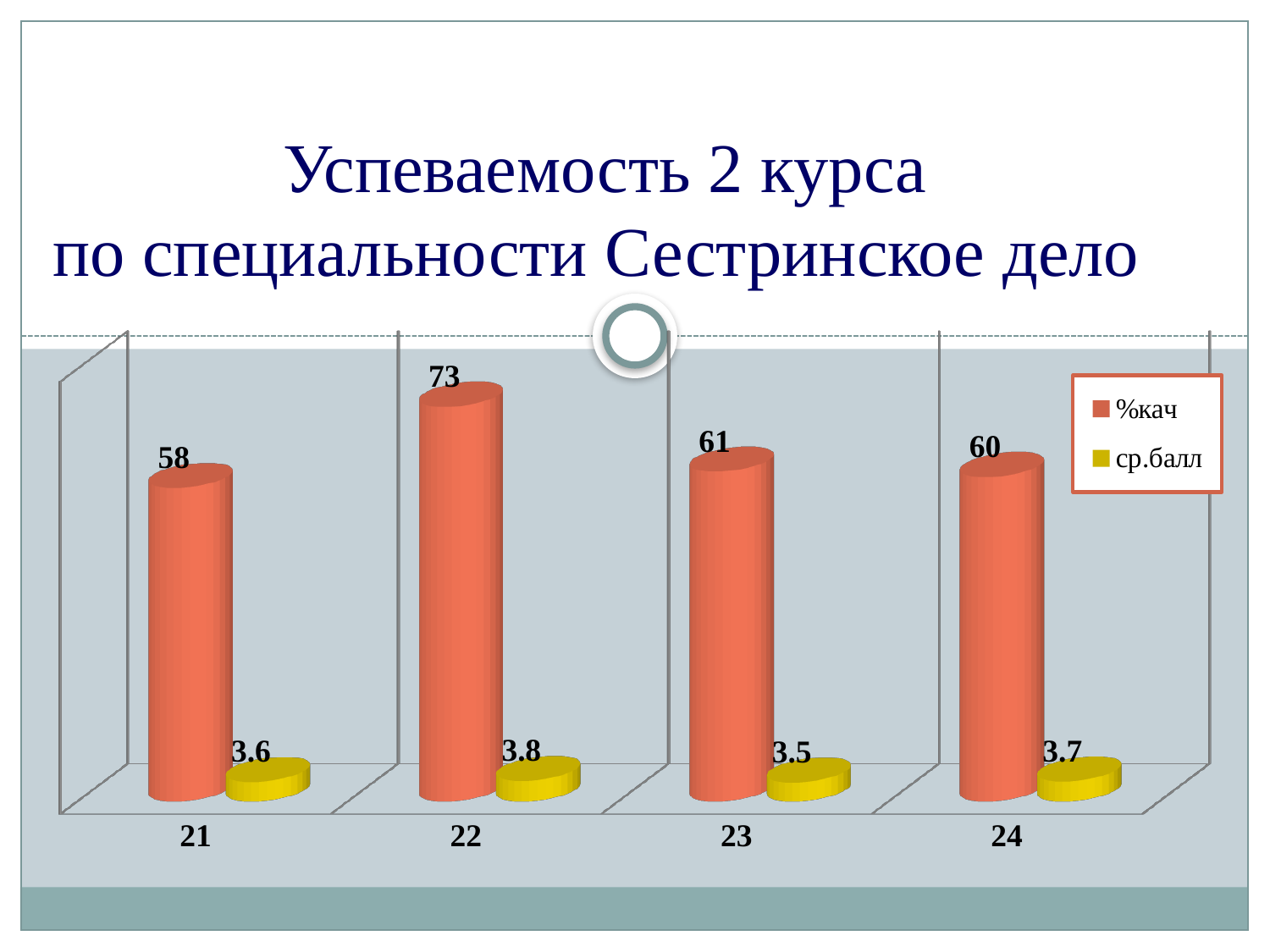
What is the %кач value for group 22? 73 What is the ср.балл value for group 23? 3.5 Which colour represents the ср.балл series in the legend? yellow What is the difference between the %кач values for groups 22 and 21? 15 Which group has the lowest ср.балл value? 23 Which group has the highest %кач value? 22 What is the difference between the ср.балл values for groups 22 and 23? 0.3 How many series does the legend list? 2 Which group has a larger %кач value, 21 or 23? 23 What is the %кач value for group 24? 60 What kind of chart is shown on the slide? bar chart How many groups are shown on the x axis? 4